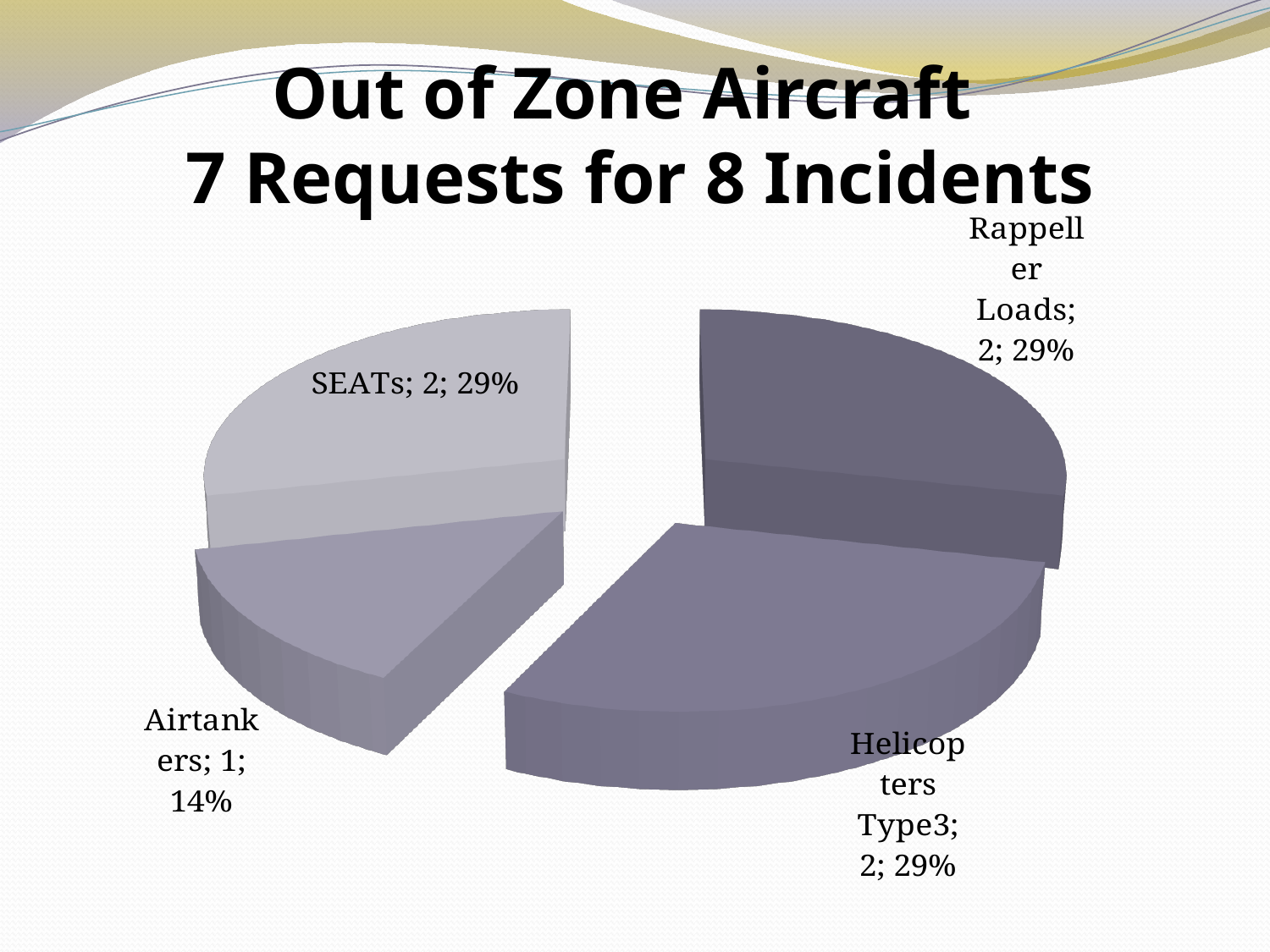
What is the total of all the slice values in the pie chart? 7 Which is larger, the value for Rappeller Loads or the value for Airtankers? Rappeller Loads What is the difference between the values for SEATs and Airtankers? 1 How many slices does the pie chart have? 4 What is the value for Airtankers? 1 What share of the pie does Rappeller Loads represent? 29% What is the title of the chart? Out of Zone Aircraft 7 Requests for 8 Incidents What is the value for SEATs? 2 Which category has the lowest value? Airtankers What kind of chart is shown on the slide? pie chart What is the value for Helicopters Type3? 2 What share of the pie does Airtankers represent? 14%